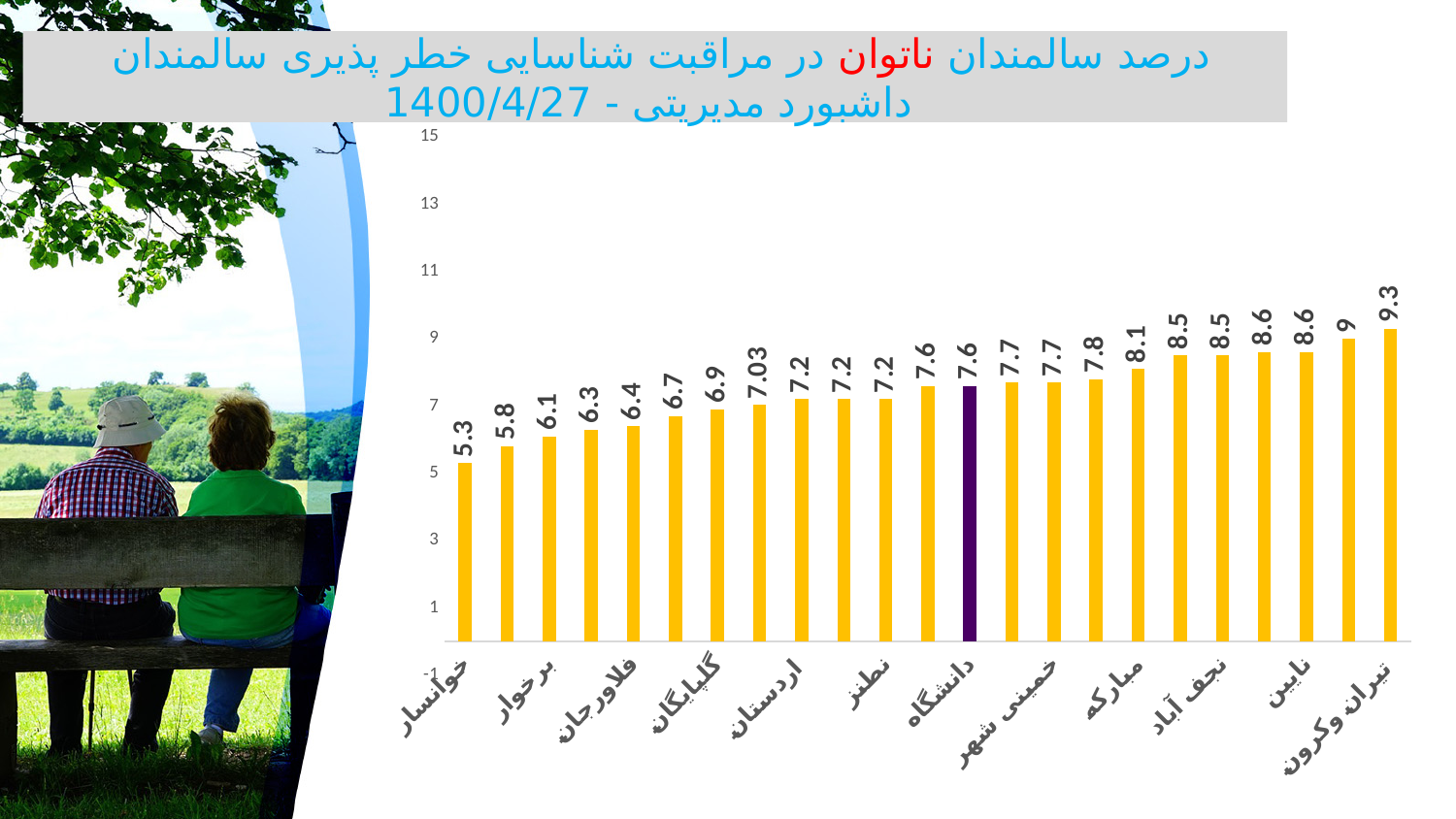
Which labelled category has the lowest value? خوانسار What is the value for تیران و کرون? 9.3 Which labelled category has the highest value? تیران و کرون How many bars are plotted in the chart? 23 What kind of chart is shown on the slide? bar chart Which is larger, the value for نجف آباد or the value for فلاورجان? نجف آباد Is the value for نایین greater or less than 7? greater What is the value for دانشگاه? 7.6 What is the value for خوانسار? 5.3 What is the difference between the values for تیران و کرون and خوانسار? 4 What is the value for مبارکه? 8.1 Which category is shown with a purple bar instead of a yellow one? دانشگاه